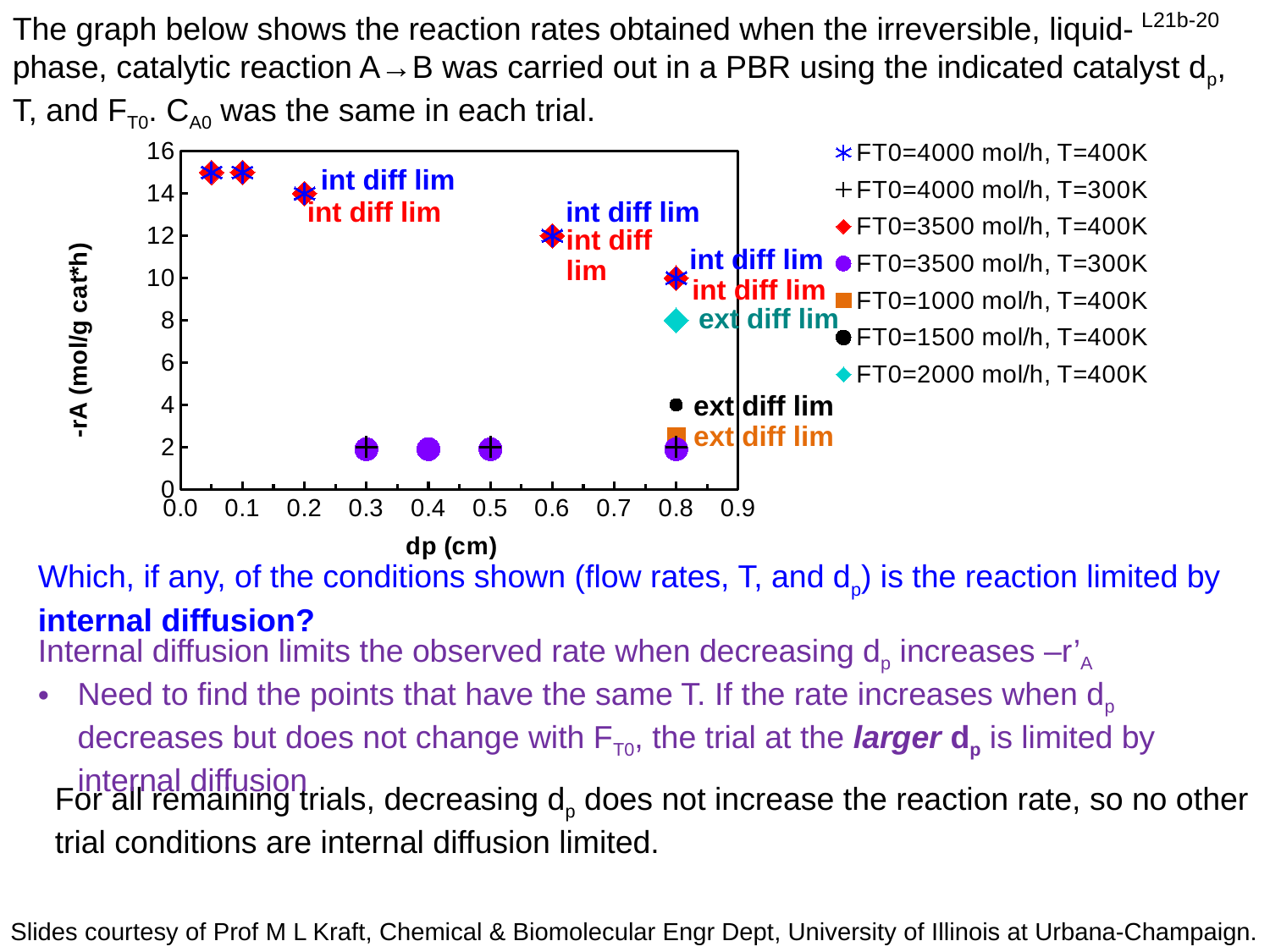
What kind of chart is shown on the slide? scatter chart At dp = 0.8 cm, which has the larger reaction rate: FT0=2000 mol/h, T=400K or FT0=1500 mol/h, T=400K? FT0=2000 mol/h, T=400K What is the reaction rate -rA at dp = 0.6 cm for FT0=4000 mol/h, T=400K? 12 What is the reaction rate -rA at dp = 0.8 cm for FT0=1500 mol/h, T=400K? 4 How many series does the legend list? 7 What is the reaction rate -rA at dp = 0.2 cm for FT0=4000 mol/h, T=400K? 14 For FT0=4000 mol/h, T=400K, what is the difference in reaction rate between dp = 0.6 cm and dp = 0.8 cm? 2 What is the label of the y axis? -rA (mol/g cat*h) What is the reaction rate -rA at dp = 0.8 cm for FT0=2000 mol/h, T=400K? 8 What is the label of the x axis? dp (cm) For the FT0=4000 mol/h, T=400K series, does the reaction rate rise or fall as dp increases? fall Is the reaction rate at dp = 0.1 cm for FT0=4000 mol/h, T=400K greater or less than 14? greater